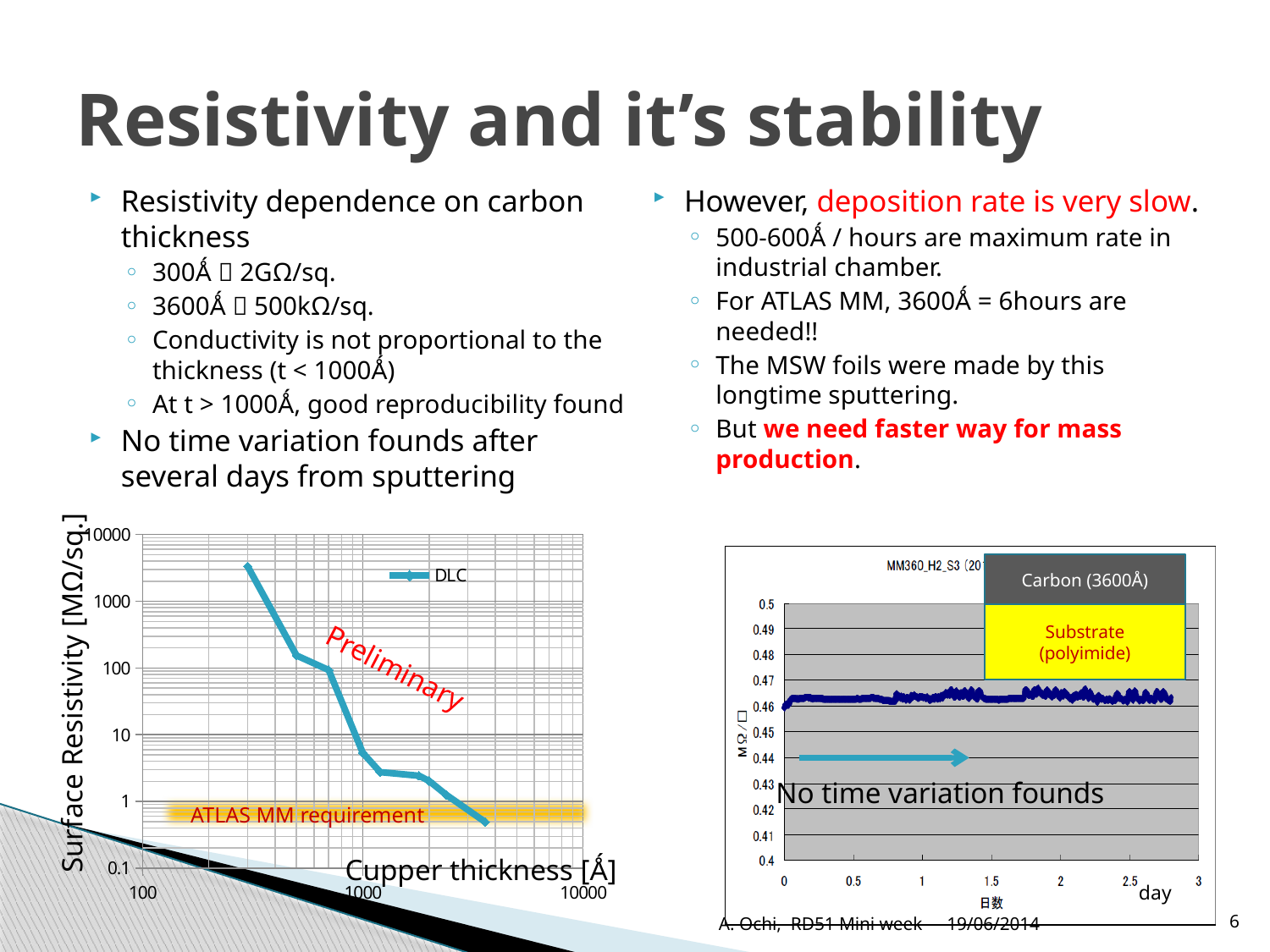
In the left chart, is the surface resistivity at the smallest plotted thickness (around 300 Å) greater or less than 1000 MΩ/sq.? greater In the right chart, is the resistivity value at day 1 greater or less than 0.45 MΩ/□? greater In the right chart, do the resistivity values rise, fall, or stay roughly flat over the days shown? stay roughly flat In the left chart, is the surface resistivity at a cupper thickness of 1000 Å greater or less than 10 MΩ/sq.? less In the left chart, what is the name of the series shown in the legend? DLC In the left chart, do the surface resistivity values rise or fall as the cupper thickness increases? fall In the left chart, how many series does the legend list? 1 In the left chart, what is the label of the y axis? Surface Resistivity [MΩ/sq.] What kind of chart is the right chart (MΩ/□ vs day)? line chart What kind of chart is the left chart (Surface Resistivity vs Cupper thickness)? line chart